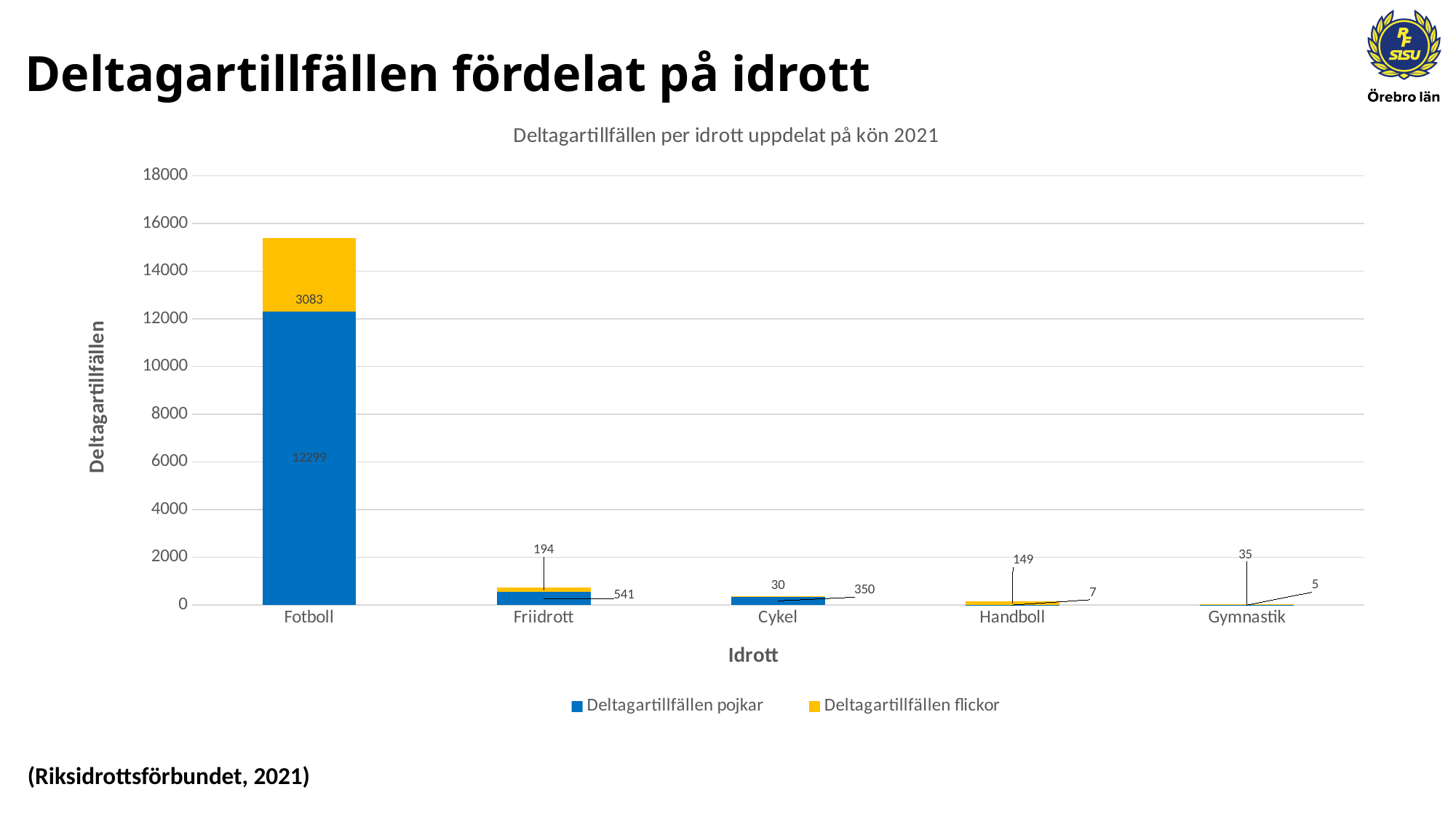
What is the title of the chart? Deltagartillfällen per idrott uppdelat på kön 2021 Which sport has the lowest total number of Deltagartillfällen? Gymnastik Is the total value of the Fotboll bar greater or less than 14000? greater What is the difference between Deltagartillfällen pojkar and Deltagartillfällen flickor for Fotboll? 9216 How many sports (categories) are shown on the x axis? 5 For Fotboll, which is larger: Deltagartillfällen pojkar or Deltagartillfällen flickor? Deltagartillfällen pojkar How many series does the legend list? 2 What is the value of Deltagartillfällen pojkar for Fotboll? 12299 What is the total of the stacked bar for Fotboll? 15382 Which sport has the highest total number of Deltagartillfällen? Fotboll What kind of chart is shown on the slide? bar chart What is the value of Deltagartillfällen flickor for Fotboll? 3083